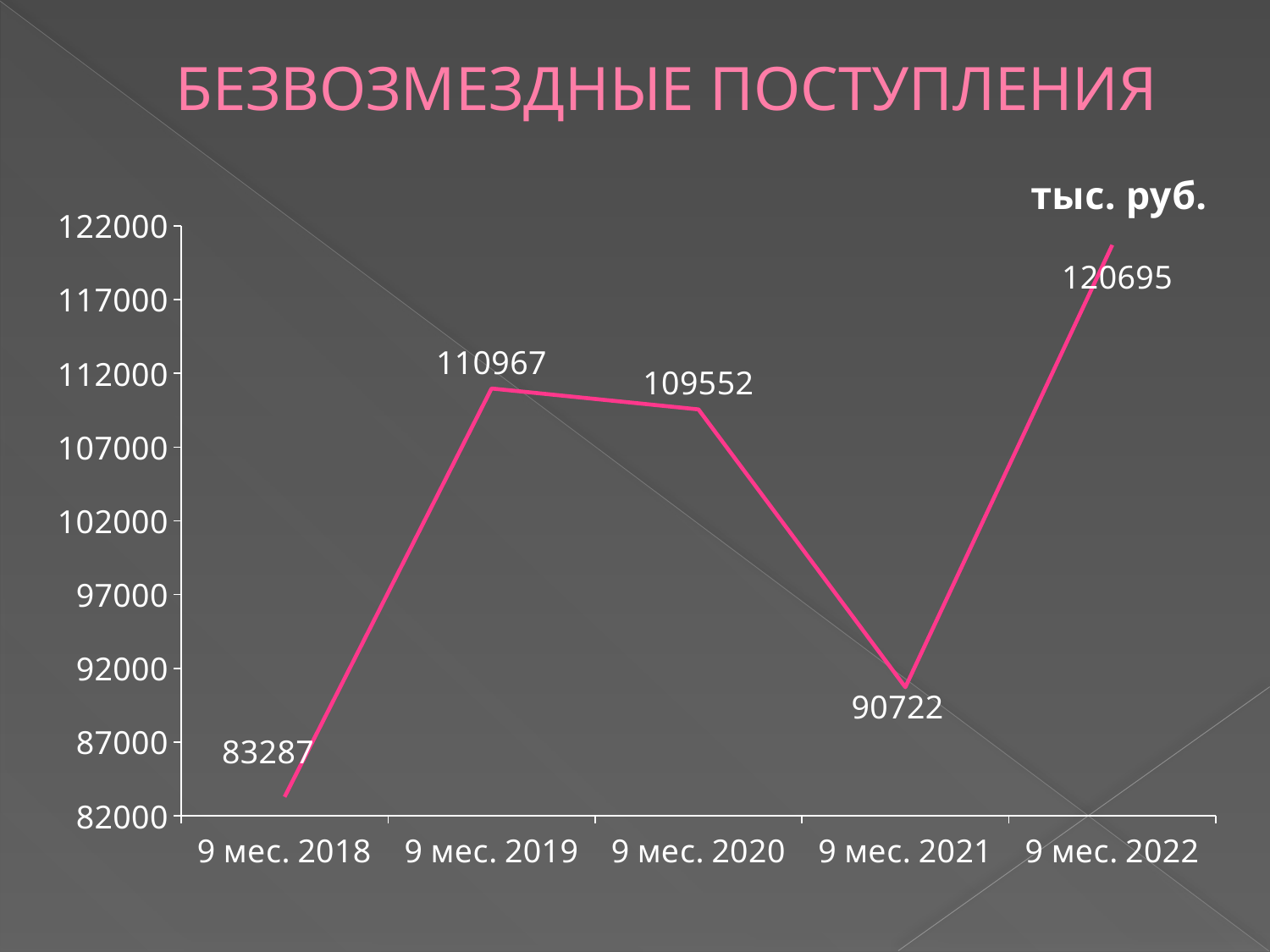
Which is larger, the value for 9 мес. 2019 or 9 мес. 2020? 9 мес. 2019 What is the value for 9 мес. 2018? 83287 What is the difference between the values for 9 мес. 2022 and 9 мес. 2021? 29973 What kind of chart is shown on the slide? line chart Which period has the lowest value? 9 мес. 2018 Which period has the highest value? 9 мес. 2022 What is the difference between the values for 9 мес. 2019 and 9 мес. 2020? 1415 Is the value for 9 мес. 2021 greater or less than 92000? less What unit is indicated for the values on the chart? тыс. руб. What is the value for 9 мес. 2021? 90722 How many periods are plotted on the chart? 5 What is the value for 9 мес. 2022? 120695